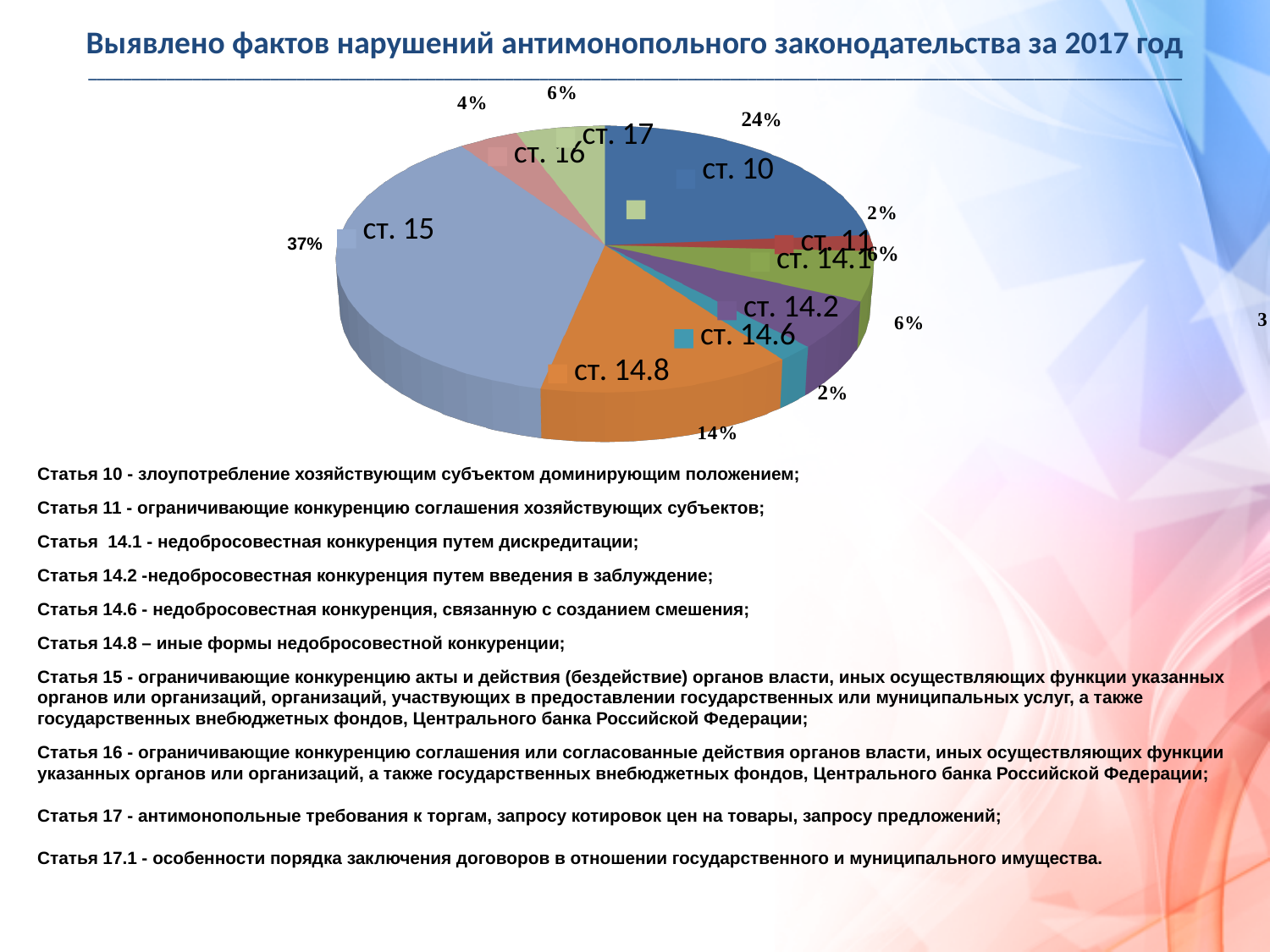
Which slice of the pie is the largest? ст. 15 What share of the pie does ст. 14.8 account for? 14% How many slices does the pie chart have? 9 What is the difference in percentage points between the ст. 14.8 slice and the ст. 16 slice? 10 Which is larger, the slice for ст. 10 or the slice for ст. 14.8? ст. 10 What share of the pie does ст. 15 account for? 37% What kind of chart is shown on the slide? pie chart What share of the pie does ст. 10 account for? 24% What share of the pie does ст. 16 account for? 4% What share of the pie does ст. 14.2 account for? 6% What is the title of the chart? Выявлено фактов нарушений антимонопольного законодательства за 2017 год What is the difference in percentage points between the ст. 15 slice and the ст. 10 slice? 13